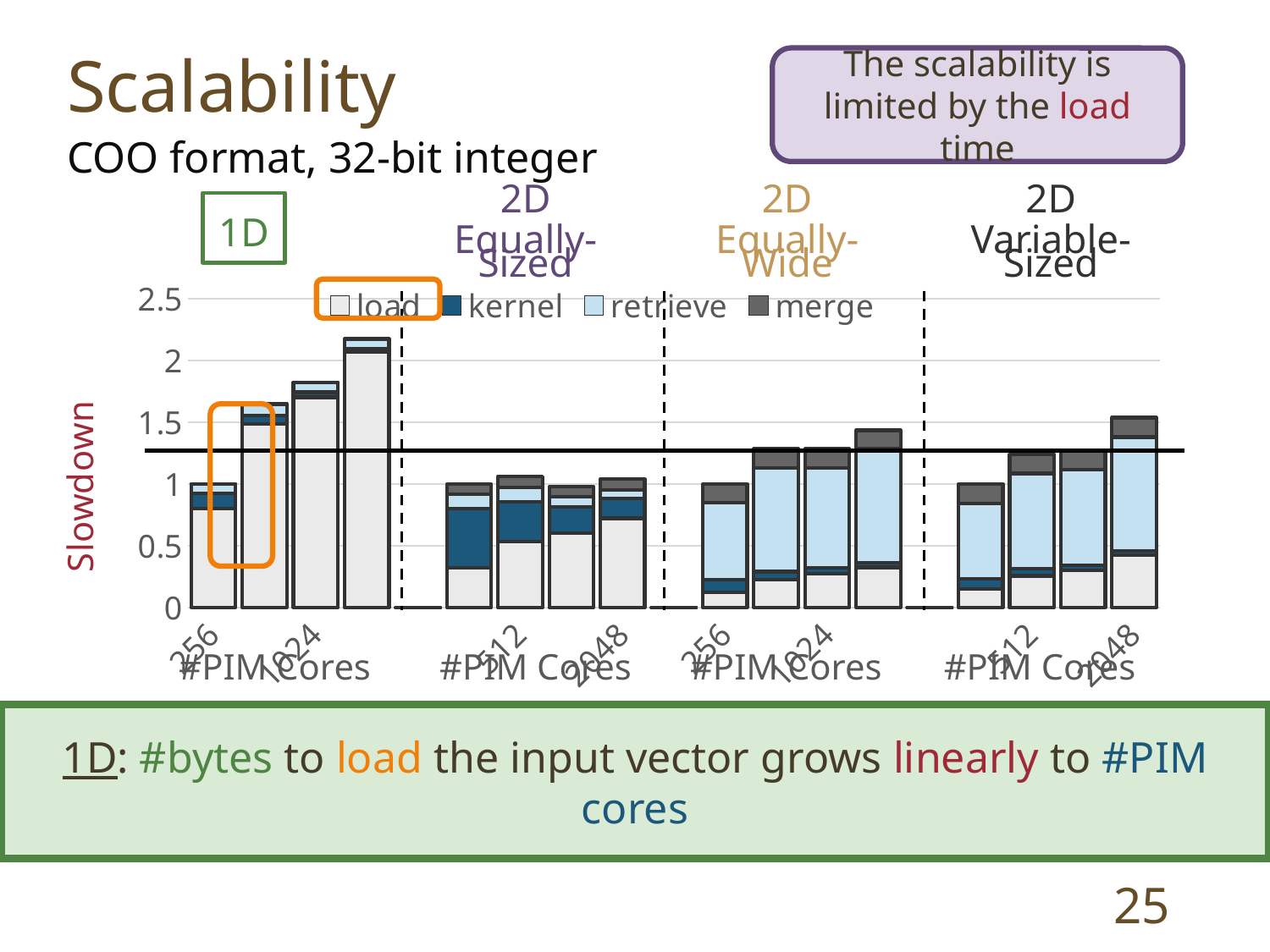
What is the label on the y-axis of the chart? Slowdown What are the four series named in the chart legend? load, kernel, retrieve, merge Which has the larger total slowdown at 2048 PIM cores: the 1D group or the 2D Equally-Sized group? 1D In the 1D group, do the stacked bar totals rise or fall as #PIM cores increases? rise Is the total slowdown for 256 PIM cores in the 1D group greater or less than 1.5? less Is the total slowdown for 2048 PIM cores in the 2D Equally-Wide group greater or less than 1? greater In the 1D group, which #PIM cores value has the highest total slowdown? 2048 How many bars are in the 1D group of the chart? 4 How many bars are plotted in total across all four groups of the chart? 16 How many series does the chart legend list? 4 What kind of chart is shown on the slide? bar chart Is the total slowdown for 2048 PIM cores in the 1D group greater or less than 2? greater